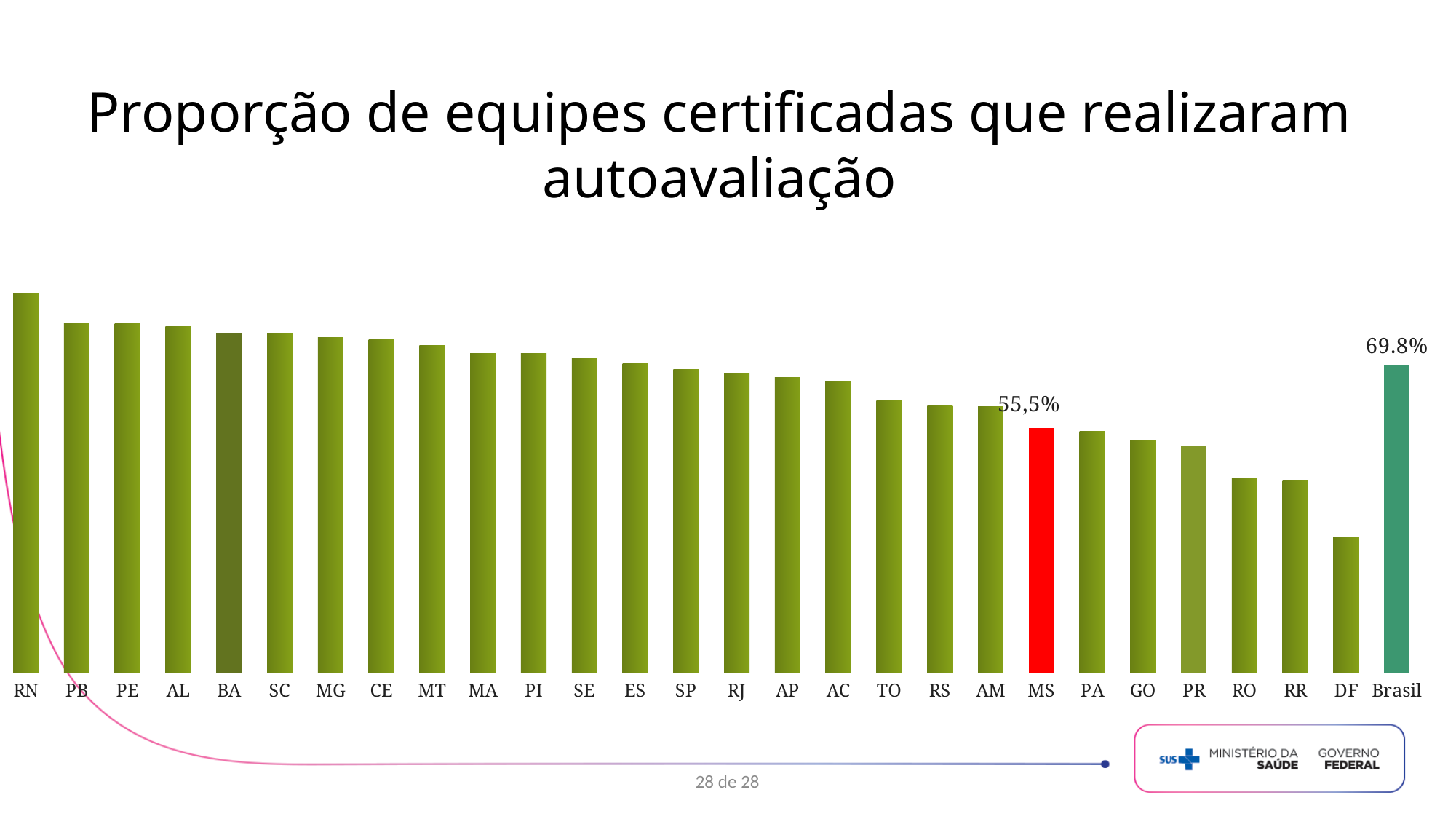
What type of chart is shown on the slide? Bar chart Do the state values rise or fall from RN on the left to DF on the right? Fall Which is larger, the value for TO or the value for DF? TO What is the value shown for Brasil? 69.8% Which category's bar is coloured red? MS What is the title of the chart? Proporção de equipes certificadas que realizaram autoavaliação Which is larger, the value for PB or the value for RR? PB What is the value shown for MS? 55,5% Which is larger, the value for MS or the value for Brasil? Brasil How many bars are plotted in the chart? 28 Which category has the lowest bar? DF Which category has the highest bar? RN